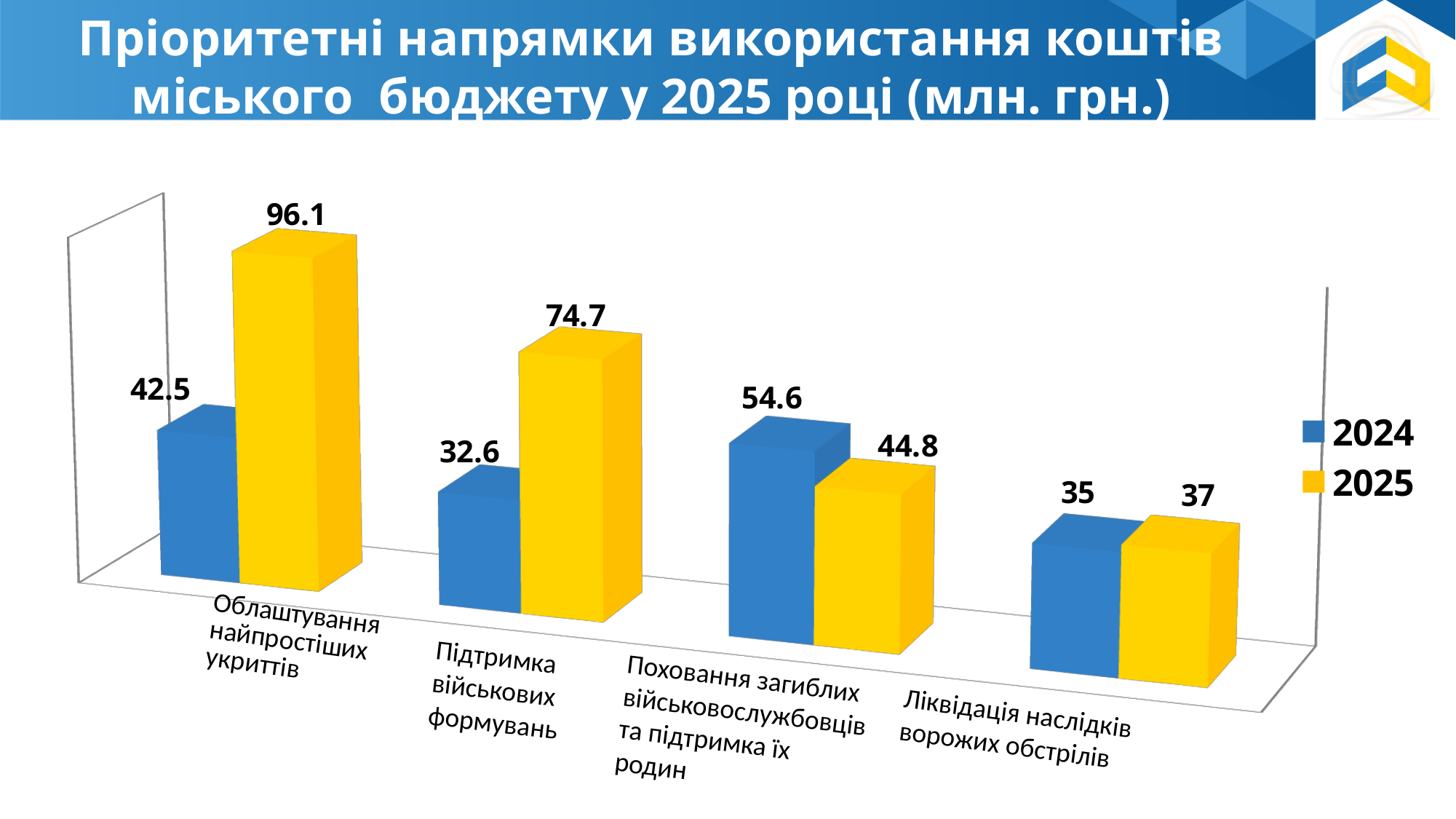
Which category has the lowest 2024 value? Підтримка військових формувань How many series does the legend list? 2 What is the 2025 value for "Облаштування найпростіших укриттів"? 96.1 What is the 2024 value for "Підтримка військових формувань"? 32.6 What is the 2024 value for "Ліквідація наслідків ворожих обстрілів"? 35 Which category has the highest 2025 value? Облаштування найпростіших укриттів What is the 2025 value for "Поховання загиблих військовослужбовців та підтримка їх родин"? 44.8 For "Поховання загиблих військовослужбовців та підтримка їх родин", which year has the larger value, 2024 or 2025? 2024 What is the difference between the 2025 and 2024 values for "Облаштування найпростіших укриттів"? 53.6 How many categories are shown on the x axis? 4 What kind of chart is shown on the slide? Bar chart Which colour represents the 2025 series in the legend? Yellow